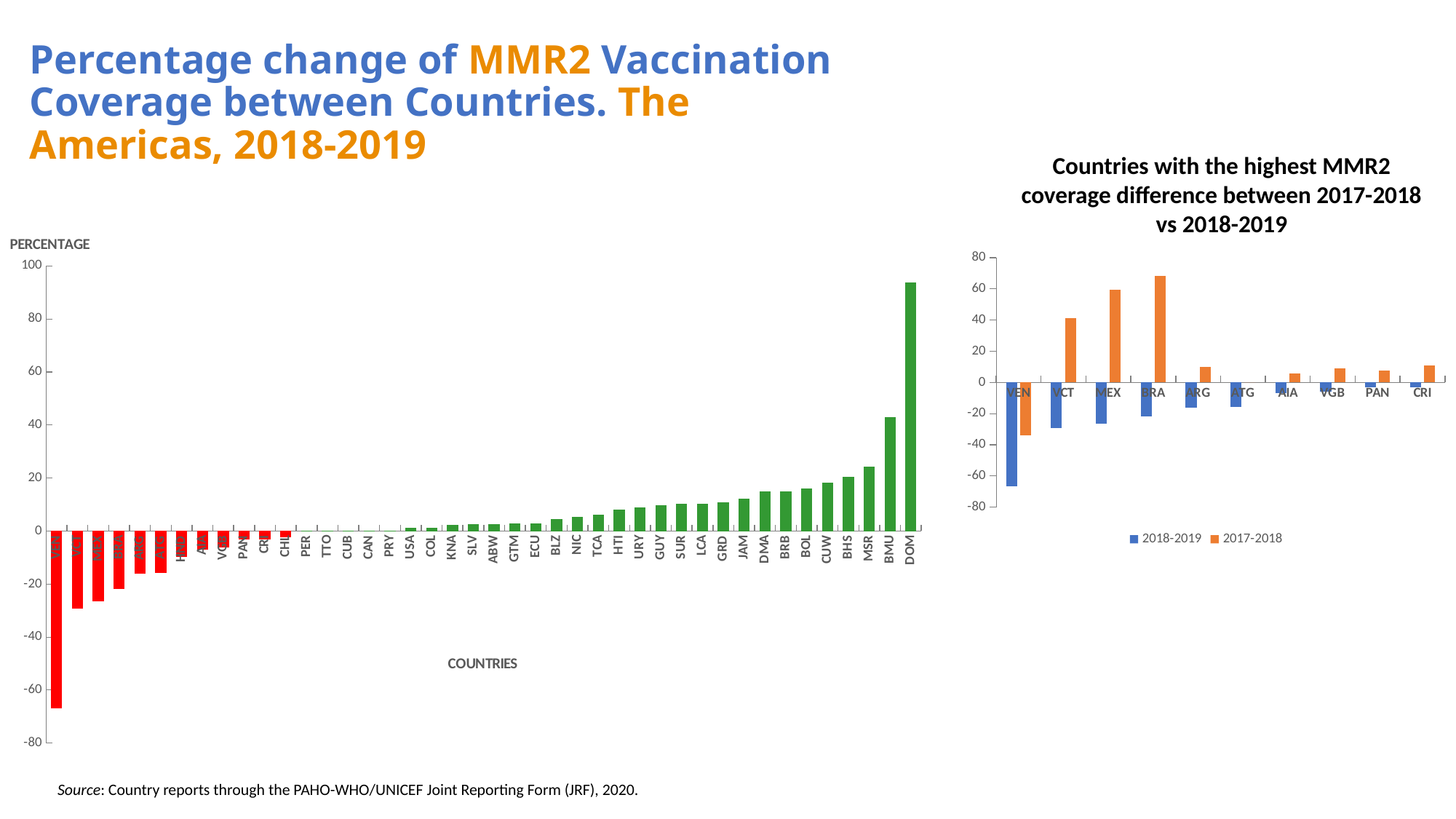
In the chart titled 'Countries with the highest MMR2 coverage difference between 2017-2018 vs 2018-2019', which country has the highest 2017-2018 value? BRA How many series does the legend list in the chart titled 'Countries with the highest MMR2 coverage difference between 2017-2018 vs 2018-2019'? 2 In the large chart on the left, is the value for VEN greater or less than -60? less In the large chart on the left, is the value for DOM greater or less than 80? greater In the large chart on the left, which country has the lowest percentage change? VEN In the large chart on the left, which is larger, the value for DOM or the value for BMU? DOM In the chart titled 'Countries with the highest MMR2 coverage difference between 2017-2018 vs 2018-2019', is the 2017-2018 value for BRA greater or less than 60? greater In the large chart on the left, what is the label of the vertical axis? PERCENTAGE What kind of chart is the large chart on the left of the slide? bar chart In the chart titled 'Countries with the highest MMR2 coverage difference between 2017-2018 vs 2018-2019', which country has the lowest 2018-2019 value? VEN In the large chart on the left, which country has the highest percentage change? DOM How many countries are shown in the chart titled 'Countries with the highest MMR2 coverage difference between 2017-2018 vs 2018-2019'? 10